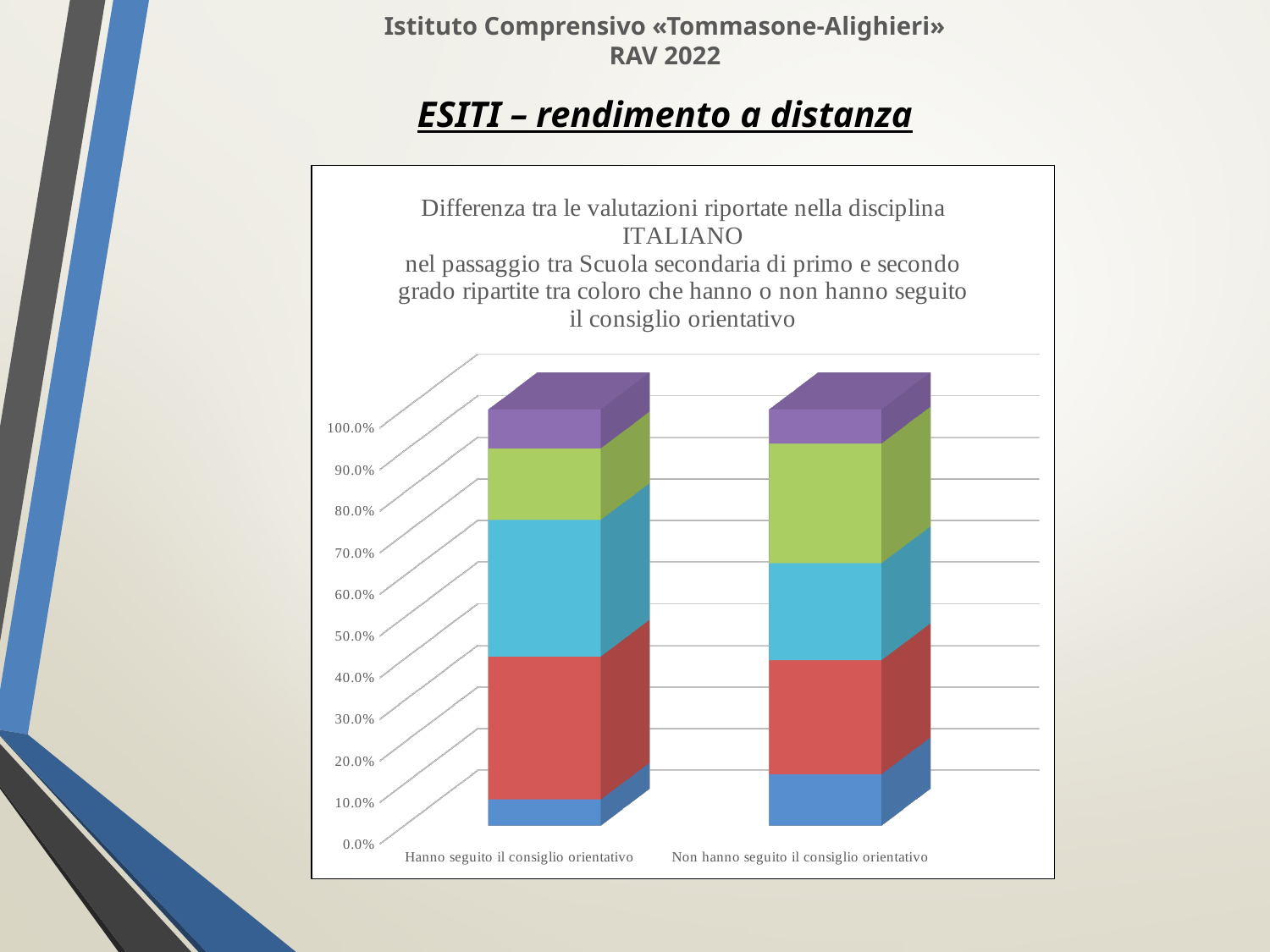
Which category has the larger red segment: 'Hanno seguito il consiglio orientativo' or 'Non hanno seguito il consiglio orientativo'? Hanno seguito il consiglio orientativo Which category has the larger blue (bottom) segment: 'Hanno seguito il consiglio orientativo' or 'Non hanno seguito il consiglio orientativo'? Non hanno seguito il consiglio orientativo Which category has the larger green segment: 'Hanno seguito il consiglio orientativo' or 'Non hanno seguito il consiglio orientativo'? Non hanno seguito il consiglio orientativo How many coloured segments make up each stacked bar? 5 What kind of chart is shown on the slide? Stacked bar chart How many categories are shown on the x axis of the chart? 2 What is the highest value labelled on the vertical axis of the chart? 100.0% Which discipline is named in the chart title? ITALIANO What are the two categories shown on the x axis? Hanno seguito il consiglio orientativo; Non hanno seguito il consiglio orientativo